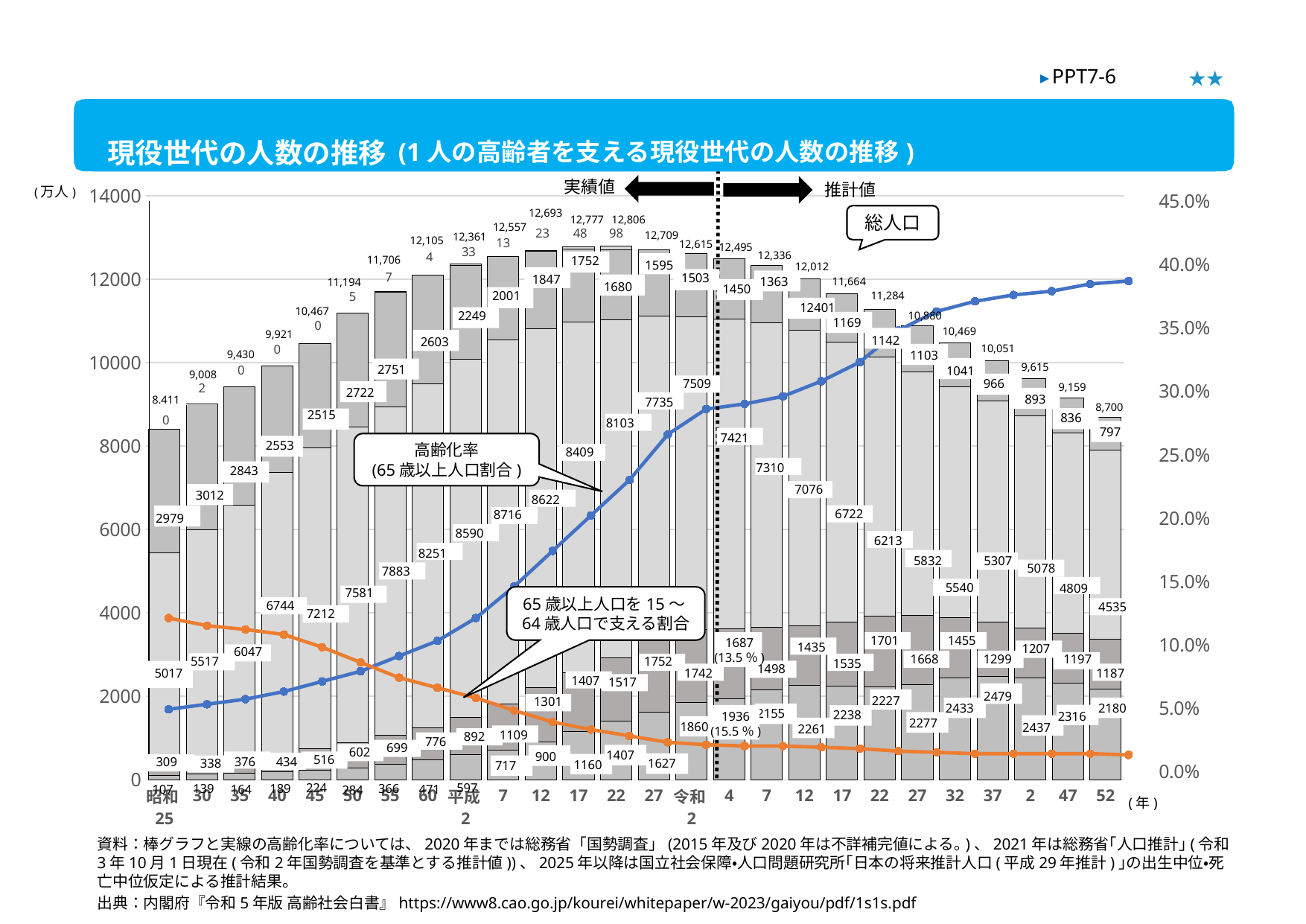
What is the total population (総人口) shown for 昭和25? 8,411 In which year is the total population (総人口) highest? 平成22 Is the 高齢化率 (blue line) value for 令和52 greater or less than 35.0%? greater What is the total population (総人口) shown for 令和52? 8,700 What is the difference between the total population in 平成22 and in 令和52? 4,106 Does the orange line (65歳以上人口を15〜64歳人口で支える割合) rise or fall from 昭和25 to 令和52? fall What is the total population (総人口) shown for 平成22? 12,806 Does the 高齢化率 (blue line) rise or fall from 昭和25 to 令和52? rise What kind of chart is this? Combined stacked bar and line chart Which is larger, the total population in 昭和25 or in 令和52? 令和52 How many years (bars) are plotted on the x axis? 26 In which year is the total population (総人口) lowest? 昭和25